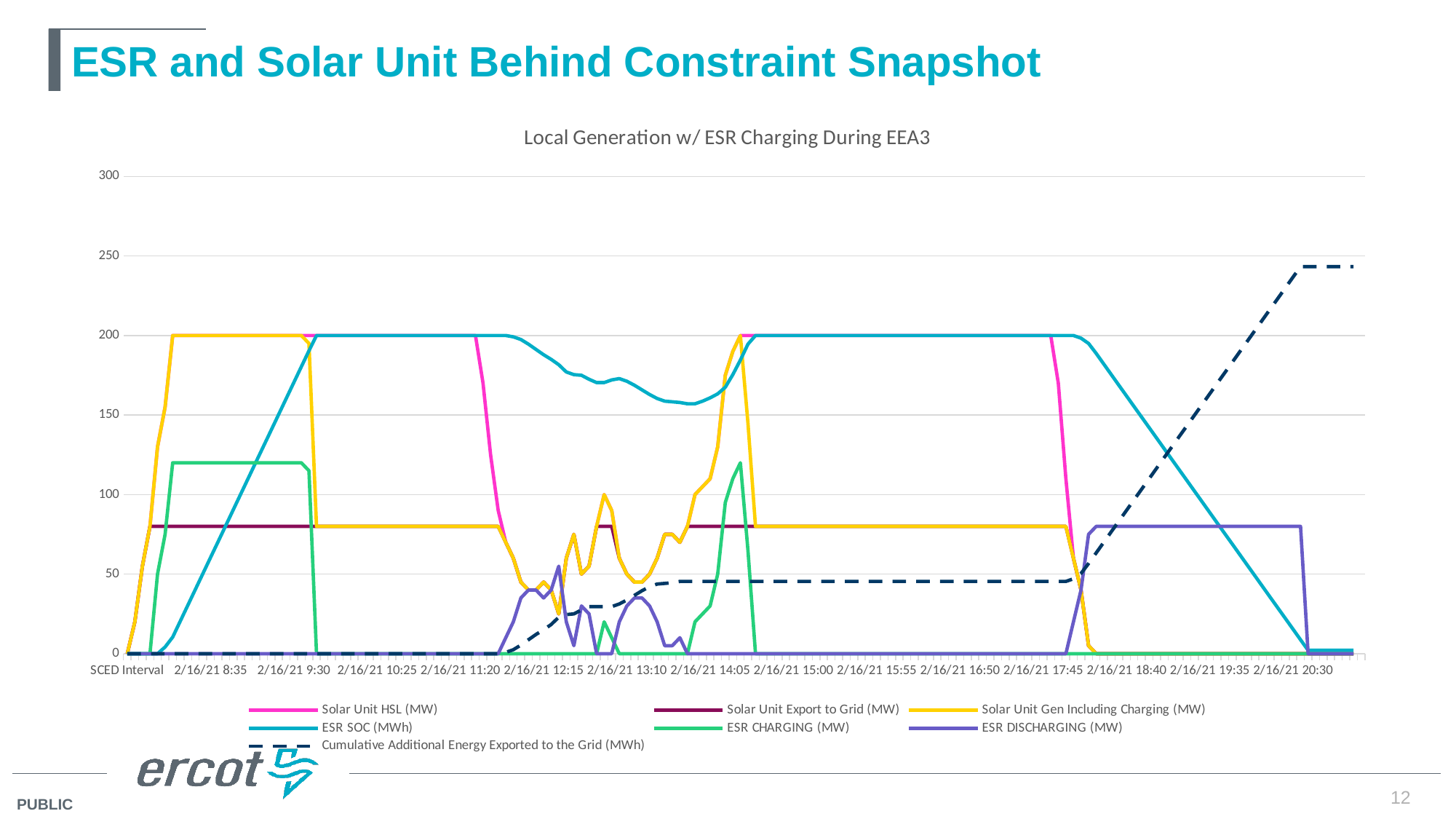
Which series is drawn as a dashed line? Cumulative Additional Energy Exported to the Grid (MWh) What is the highest value reached by the Solar Unit HSL (MW) series? 200 Is the value of ESR DISCHARGING (MW) at 2/16/21 19:35 greater or less than 50? greater Does the Cumulative Additional Energy Exported to the Grid (MWh) series rise or fall between 2/16/21 17:45 and 2/16/21 19:35? Rise What is the title of the chart? Local Generation w/ ESR Charging During EEA3 Is the value of ESR SOC (MWh) at 2/16/21 15:00 greater or less than 150? greater What kind of chart is shown on the slide? Line chart Does the ESR SOC (MWh) series rise or fall between 2/16/21 18:40 and 2/16/21 20:30? Fall Is the value of Cumulative Additional Energy Exported to the Grid (MWh) at 2/16/21 20:30 greater or less than 200? greater How many series does the legend list? 7